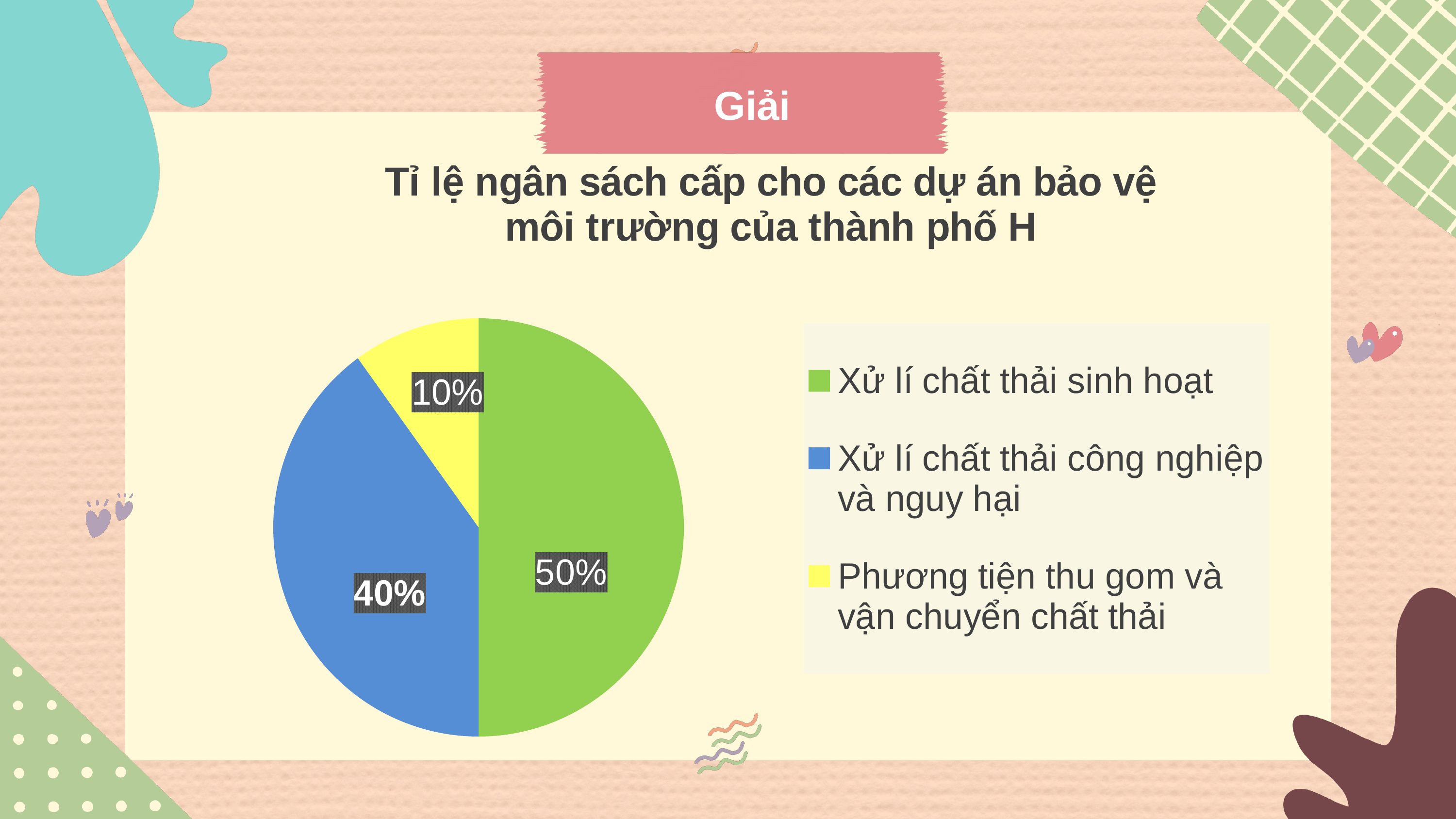
What colour is the slice for 'Phương tiện thu gom và vận chuyển chất thải'? Yellow What percentage of the budget goes to 'Phương tiện thu gom và vận chuyển chất thải'? 10% Which is larger: the share for 'Xử lí chất thải công nghiệp và nguy hại' or the share for 'Phương tiện thu gom và vận chuyển chất thải'? Xử lí chất thải công nghiệp và nguy hại What is the combined share of 'Xử lí chất thải công nghiệp và nguy hại' and 'Phương tiện thu gom và vận chuyển chất thải'? 50% What percentage of the budget goes to 'Xử lí chất thải sinh hoạt'? 50% Which category has the largest share of the pie? Xử lí chất thải sinh hoạt What is the difference between the share for 'Xử lí chất thải sinh hoạt' and the share for 'Xử lí chất thải công nghiệp và nguy hại'? 10% What kind of chart is shown on the slide? Pie chart Which category has the smallest share of the pie? Phương tiện thu gom và vận chuyển chất thải How many categories does the pie chart have? 3 What percentage of the budget goes to 'Xử lí chất thải công nghiệp và nguy hại'? 40% What is the title of the chart? Tỉ lệ ngân sách cấp cho các dự án bảo vệ môi trường của thành phố H